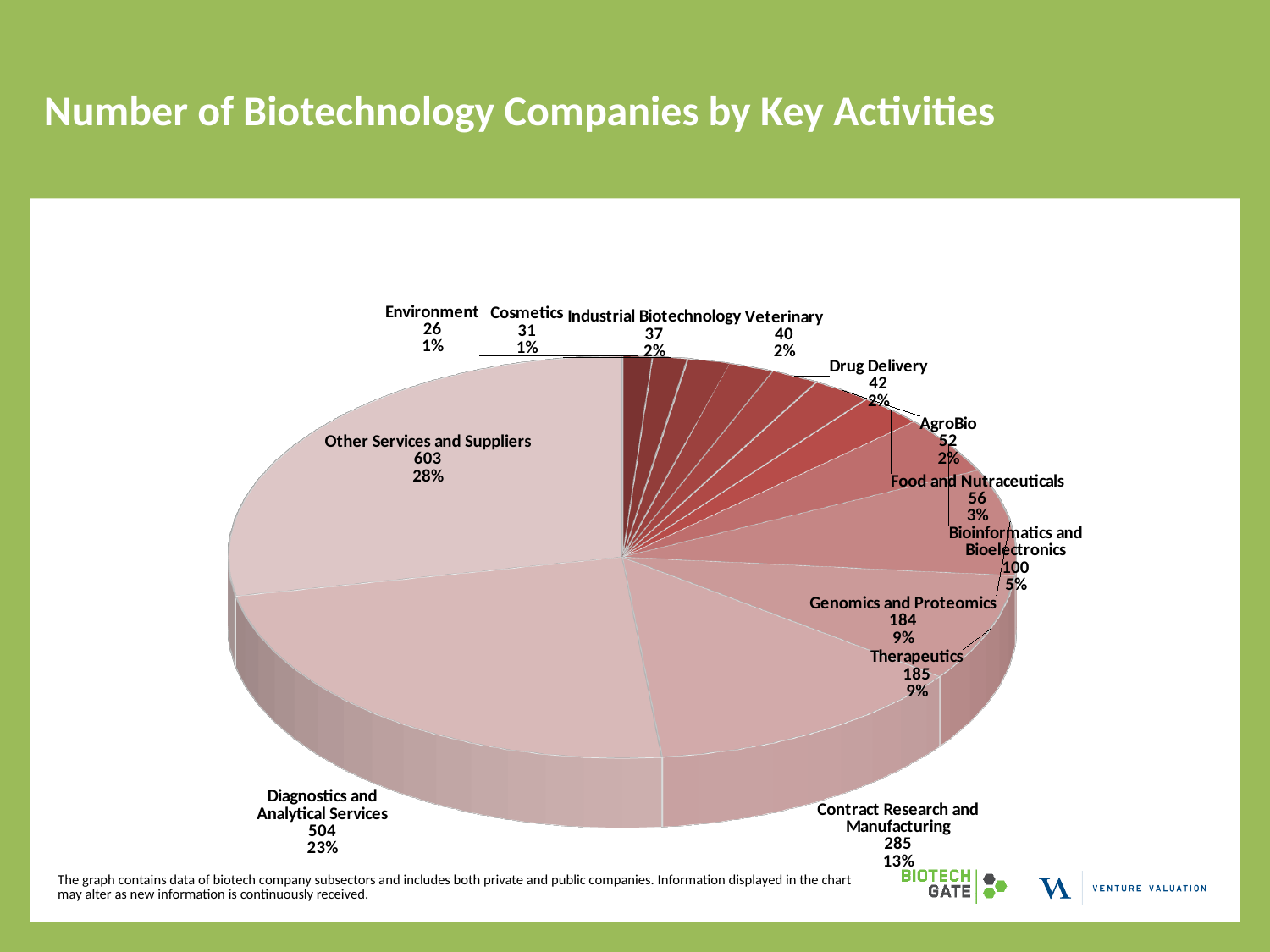
Which has more companies, Genomics and Proteomics or Bioinformatics and Bioelectronics? Genomics and Proteomics How many companies are in the Contract Research and Manufacturing category? 285 What share of the pie does Diagnostics and Analytical Services represent? 23% What is the title of the chart? Number of Biotechnology Companies by Key Activities How many biotechnology companies are in the Other Services and Suppliers category? 603 Which category has the largest number of companies? Other Services and Suppliers What percentage share does Bioinformatics and Bioelectronics have? 5% How many companies are in the Veterinary category? 40 Which category has the smallest number of companies? Environment How many categories are shown in the pie chart? 13 What is the difference in the number of companies between Other Services and Suppliers and Diagnostics and Analytical Services? 99 What kind of chart is shown on the slide? Pie chart